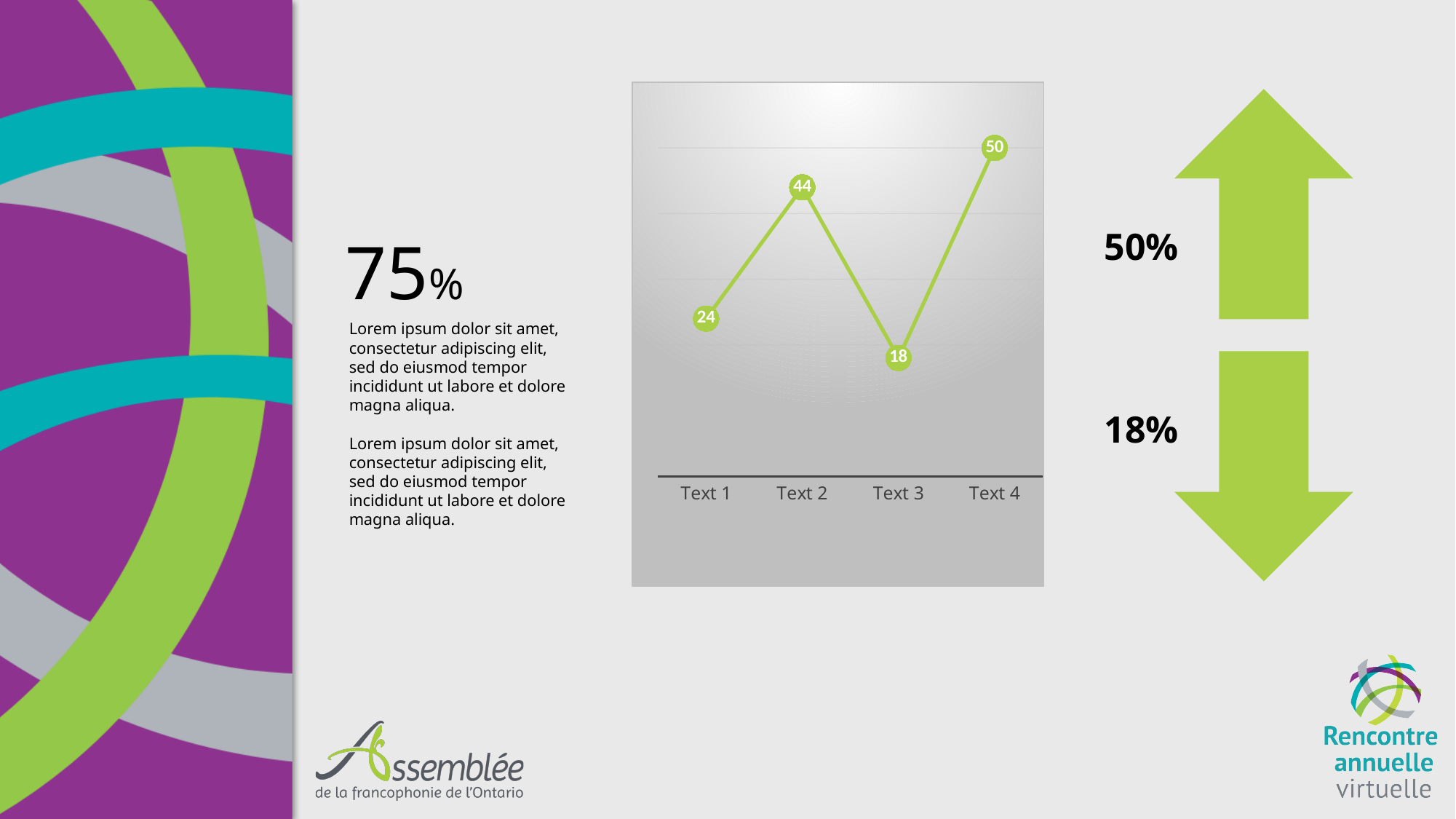
Which category has the highest value in the line chart? Text 4 What is the value for Text 1 in the line chart? 24 What is the difference between the values for Text 2 and Text 1? 20 How many data points are plotted in the line chart? 4 Which category has the lowest value in the line chart? Text 3 What kind of chart is shown on the slide? Line chart What is the difference between the values for Text 4 and Text 3? 32 What is the value for Text 4 in the line chart? 50 Which is larger, the value for Text 2 or the value for Text 1? Text 2 What is the value for Text 2 in the line chart? 44 Does the value rise or fall from Text 2 to Text 3? Fall What is the value for Text 3 in the line chart? 18